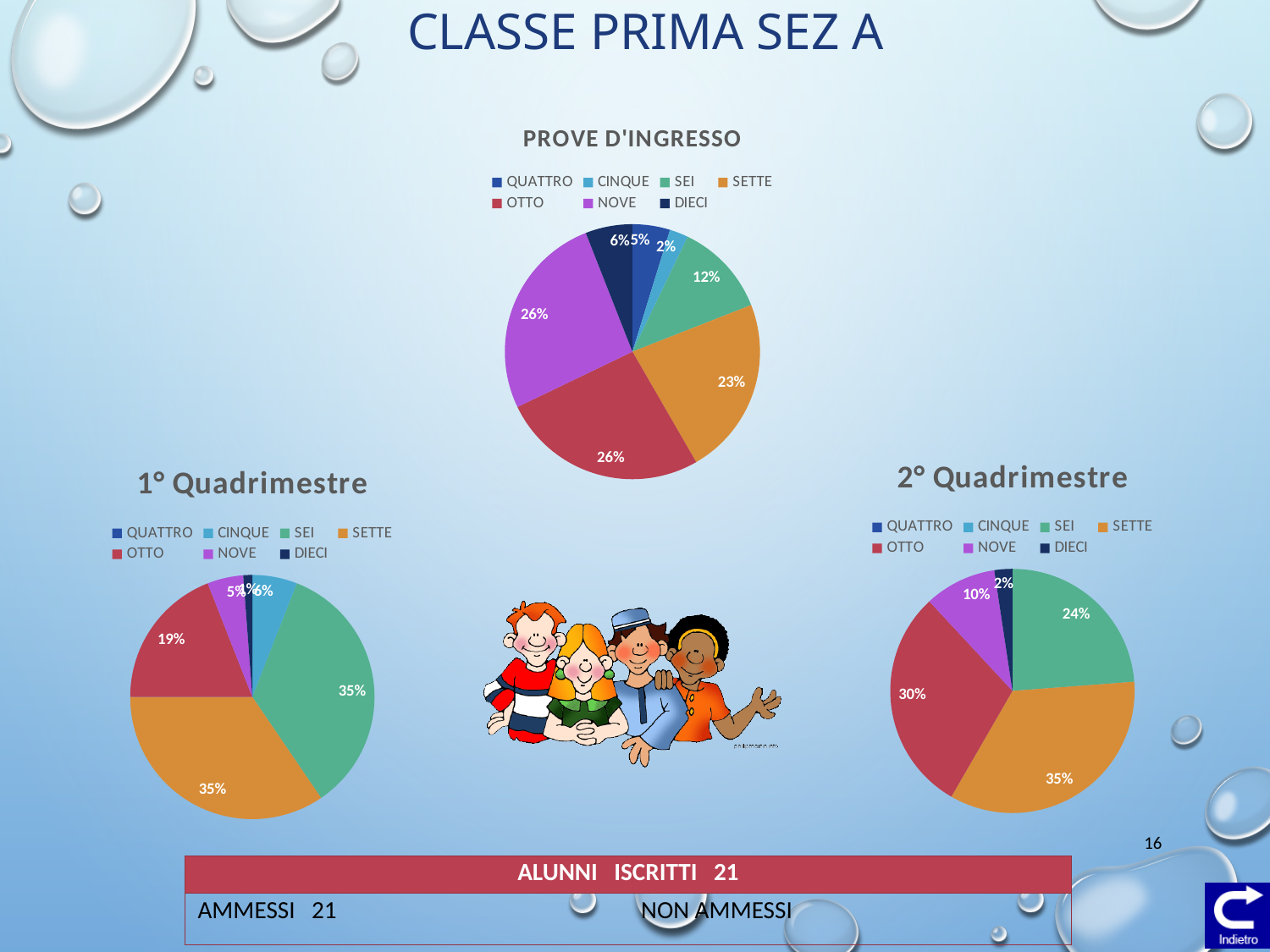
In the 2° Quadrimestre pie chart, which is larger, the slice for SEI or the slice for OTTO? OTTO What type of chart is used for the 1° Quadrimestre data? Pie chart In the 2° Quadrimestre pie chart, how many percentage points larger is SETTE than SEI? 11 percentage points In the 1° Quadrimestre pie chart, what percentage is shown for OTTO? 19% In the 2° Quadrimestre pie chart, what percentage is shown for OTTO? 30% In the 2° Quadrimestre pie chart, what percentage is shown for NOVE? 10% In the PROVE D'INGRESSO pie chart, what percentage is shown for SEI? 12% In the PROVE D'INGRESSO pie chart, which category has the smallest slice? CINQUE How many entries does the legend of the PROVE D'INGRESSO chart list? 7 In the 2° Quadrimestre pie chart, which category has the largest slice? SETTE In the PROVE D'INGRESSO pie chart, what percentage is shown for SETTE? 23% In the 1° Quadrimestre pie chart, what percentage is shown for SEI? 35%